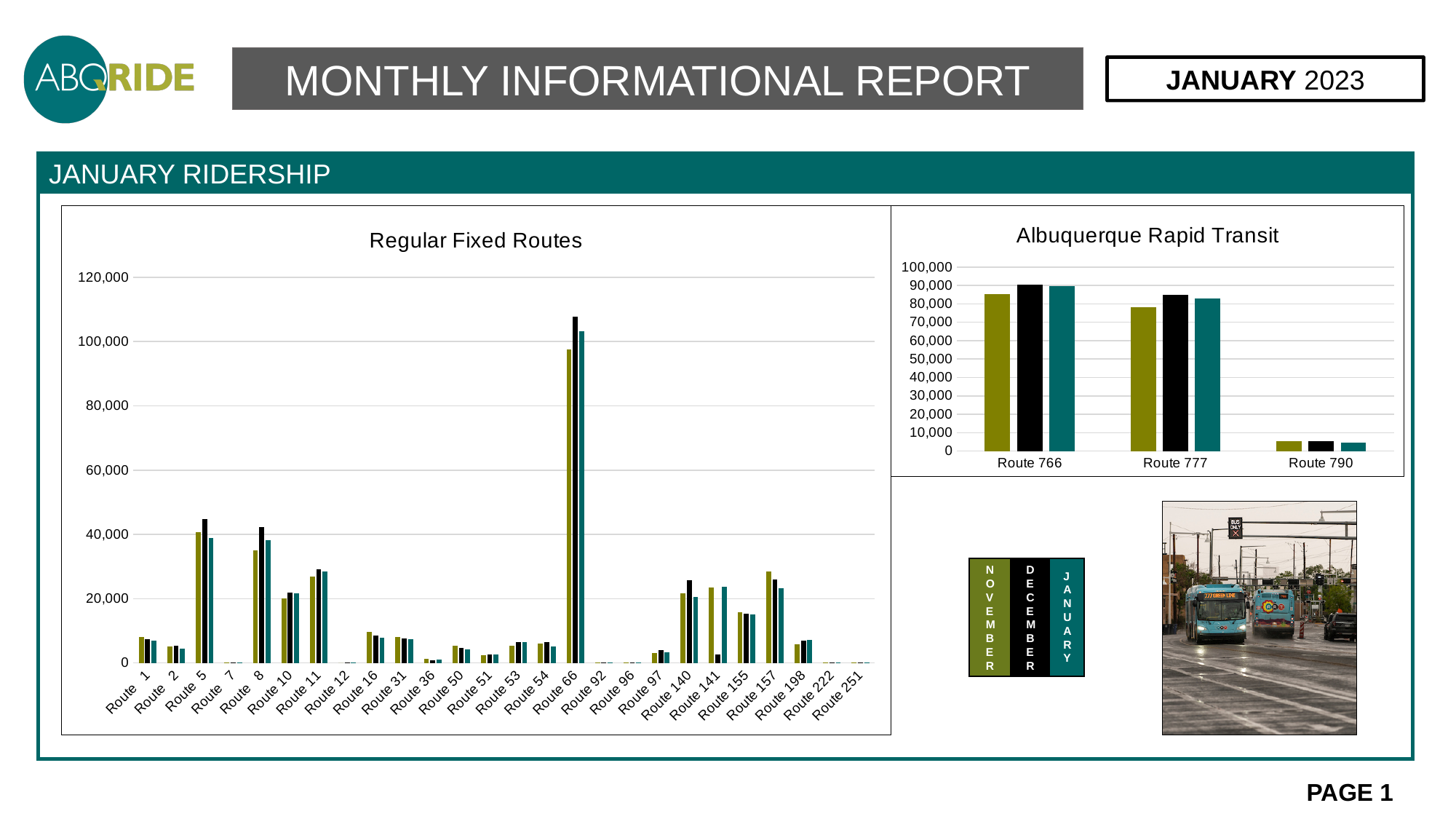
In the Albuquerque Rapid Transit chart, do the values rise or fall from Route 766 to Route 790? fall How many routes are shown on the x axis of the Regular Fixed Routes chart? 26 How many months does the legend list for the ridership charts? 3 How many routes are shown in the Albuquerque Rapid Transit chart? 3 In the Albuquerque Rapid Transit chart, is the January value for Route 790 greater or less than 10,000? less In the Regular Fixed Routes chart, is the November value for Route 8 greater or less than 40,000? less In the Regular Fixed Routes chart, which is larger in December: Route 140 or Route 141? Route 140 In the Regular Fixed Routes chart, is the December value for Route 66 greater or less than 100,000? greater In the Regular Fixed Routes chart, which route has the highest ridership? Route 66 In the Albuquerque Rapid Transit chart, which route has the lowest ridership? Route 790 What kind of chart is the Regular Fixed Routes chart? bar chart